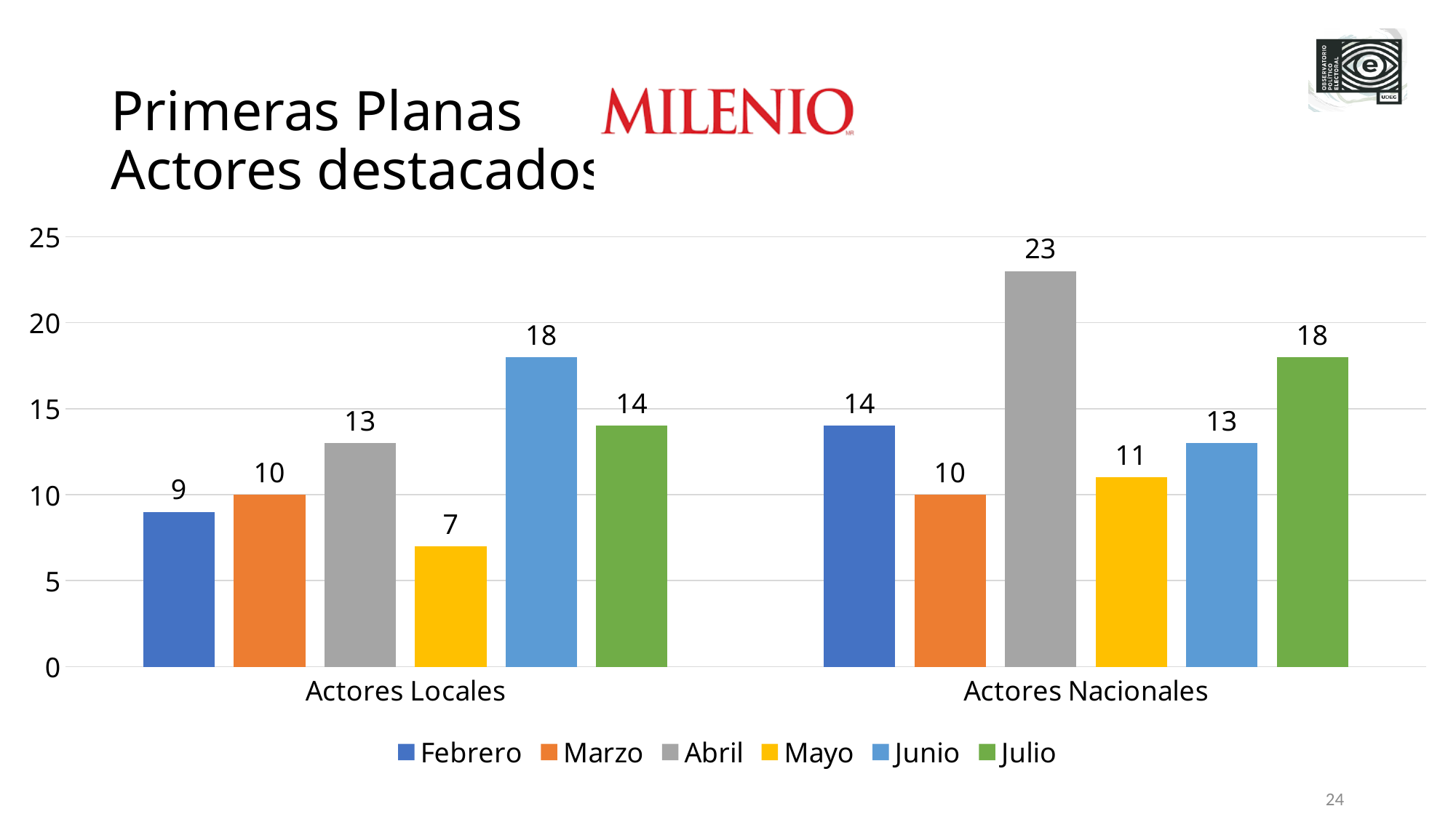
Is the value for Julio in Actores Nacionales greater or less than 15? greater Which month has the lowest value in the Actores Locales category? Mayo What kind of chart is shown on the slide? bar chart Which colour represents Mayo in the legend? yellow What is the value for Junio in the Actores Locales category? 18 What is the value for Abril in the Actores Nacionales category? 23 What is the difference between the Abril values for Actores Nacionales and Actores Locales? 10 What is the value for Mayo in the Actores Locales category? 7 How many series does the legend list? 6 Which is larger: the Febrero value for Actores Locales or for Actores Nacionales? Actores Nacionales How many categories are shown on the x axis? 2 Which month has the highest value in the Actores Nacionales category? Abril